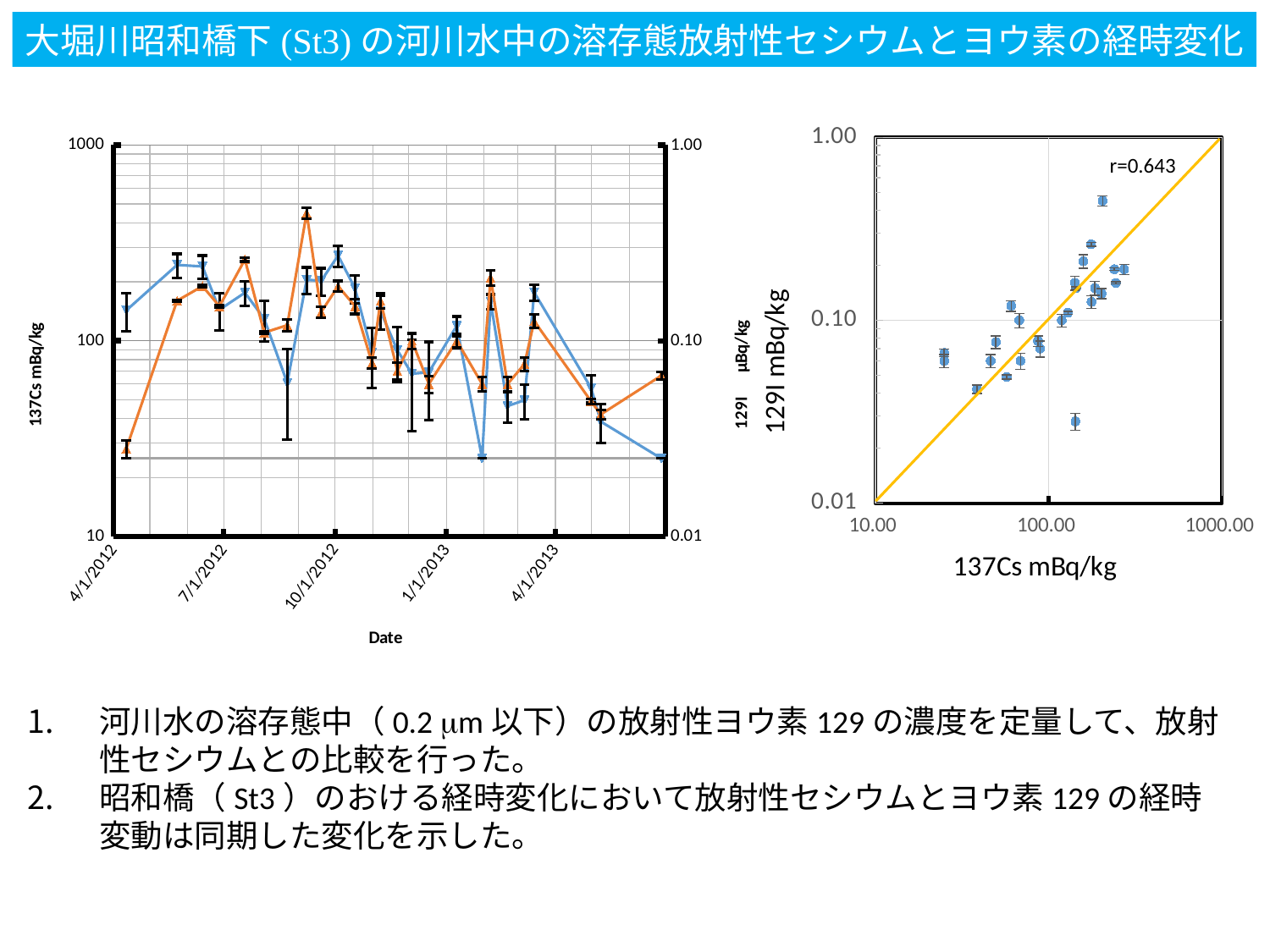
In the scatter plot on the right, what is the label of the x axis? 137Cs mBq/kg In the scatter plot on the right, what correlation coefficient is printed on the chart? r=0.643 In the line chart on the left, is the first orange-line value near 4/1/2012 greater or less than 100 on the left axis? less What kind of chart is the chart on the left of the slide? line chart In the line chart on the left, is the highest orange-line peak (around September 2012) greater or less than 1000 on the left axis? less In the scatter plot on the right, is the lowest point's 129I value greater or less than 0.10? less What kind of chart is the chart on the right of the slide? scatter plot In the line chart on the left, how many lines (series) are plotted? 3 In the scatter plot on the right, do the 129I values tend to rise or fall as 137Cs increases? rise